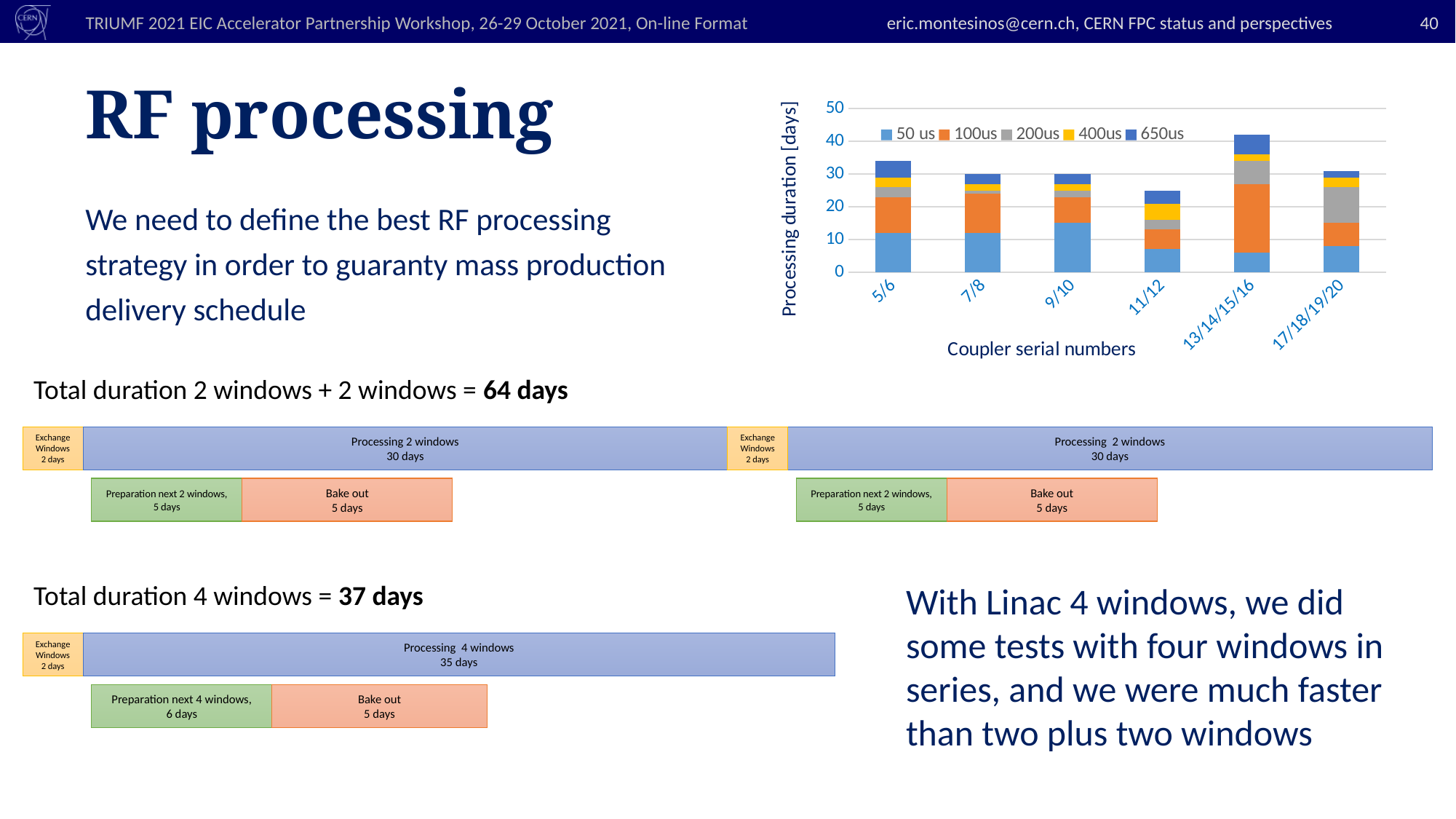
Is the total processing duration for 13/14/15/16 greater or less than 40 days? greater Which coupler serial number has the lowest total processing duration? 11/12 Is the total processing duration for 11/12 greater or less than 30 days? less Which has the larger total processing duration, 5/6 or 11/12? 5/6 What is the title of the horizontal axis of the chart? Coupler serial numbers Which coupler serial number has the highest total processing duration? 13/14/15/16 What is the title of the vertical axis of the chart? Processing duration [days] How many coupler serial number categories are shown on the x axis of the chart? 6 What kind of chart is shown on the slide? bar chart Is the total processing duration for 5/6 greater or less than 30 days? greater Which has the larger total processing duration, 13/14/15/16 or 11/12? 13/14/15/16 How many series does the chart legend list? 5